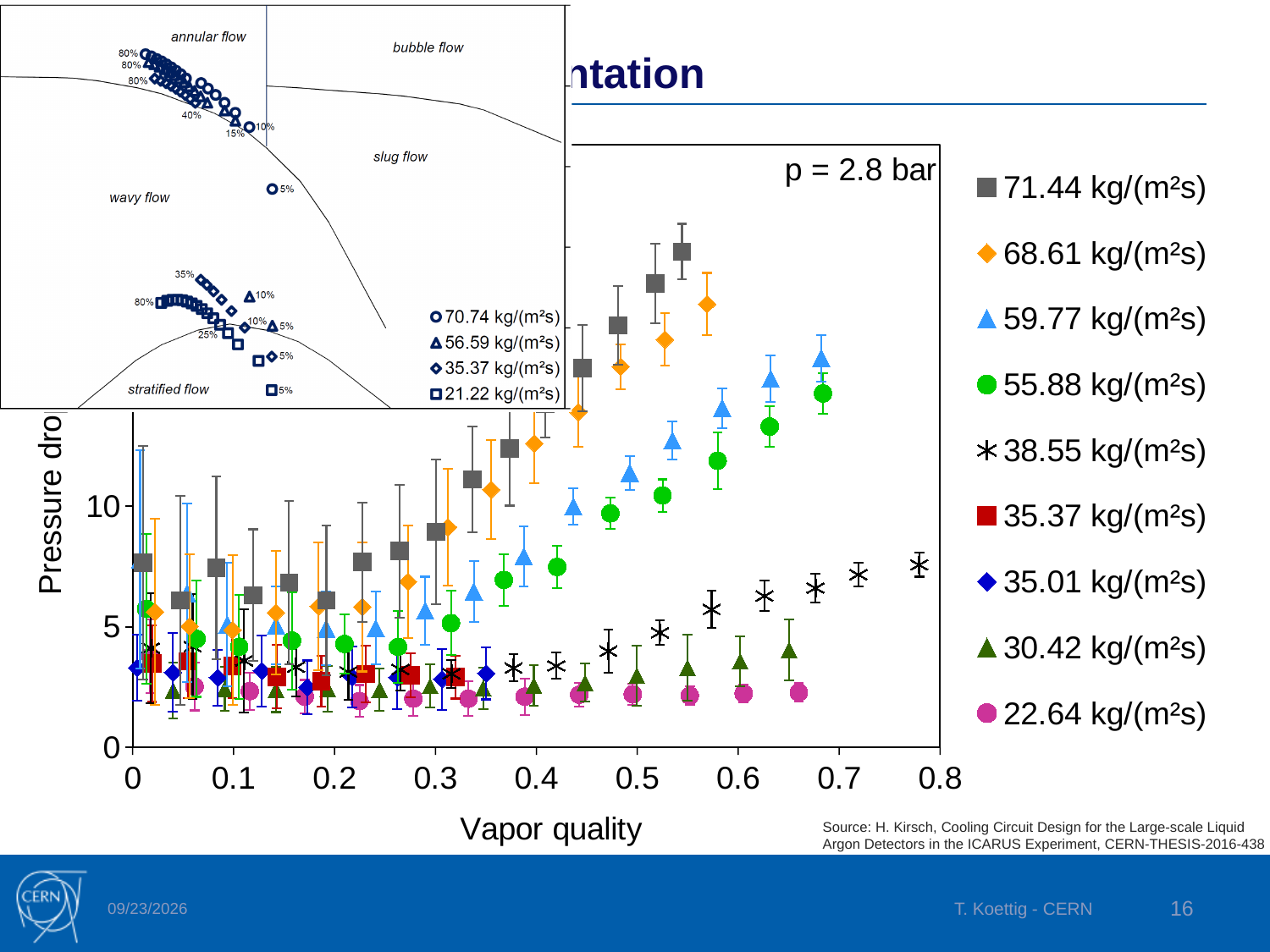
On the main chart, is the value for the 38.55 kg/(m²s) series at vapor quality 0.75 greater or less than 5? greater On the main chart, what is the label of the x axis? Vapor quality On the main chart, does the pressure drop for the 71.44 kg/(m²s) series rise or fall as vapor quality increases from 0.2 to 0.55? rise On the main chart, is the value for the 71.44 kg/(m²s) series at vapor quality 0.55 greater or less than 10? greater On the main chart, at vapor quality 0.5, which series has the larger pressure drop: 71.44 kg/(m²s) or 55.88 kg/(m²s)? 71.44 kg/(m²s) What kind of chart is the main chart of pressure drop versus vapor quality? scatter chart On the main chart, is the value for the 22.64 kg/(m²s) series at vapor quality 0.65 greater or less than 5? less On the inset flow-pattern map in the top left, how many series does the legend list? 4 On the main chart, what pressure is stated in the annotation at the top right of the plot area? p = 2.8 bar On the main chart, which series has the lowest pressure drop values at high vapor quality? 22.64 kg/(m²s) On the main chart, how many series does the legend list? 9 On the main chart, which series reaches the highest pressure drop? 71.44 kg/(m²s)